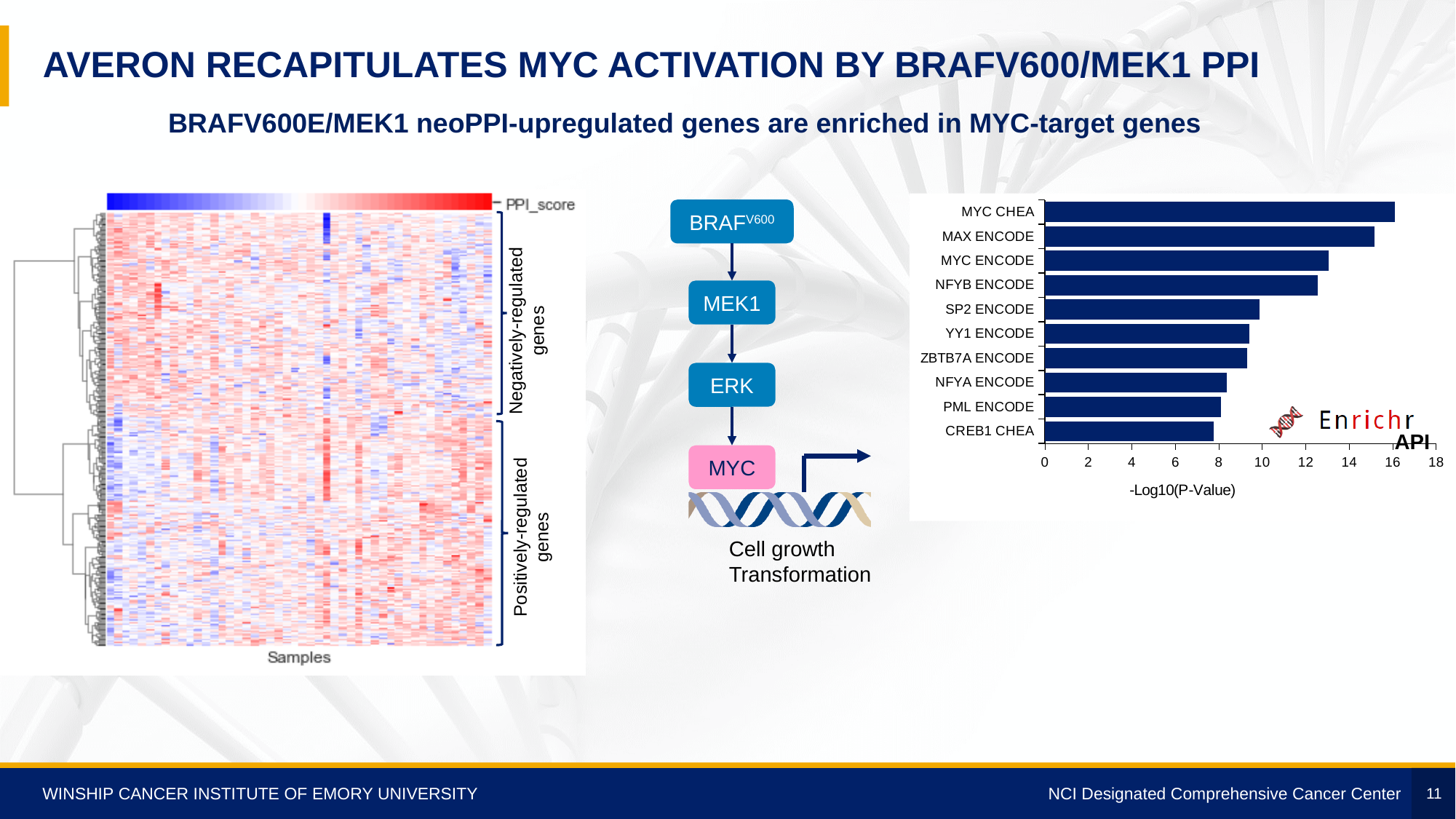
In the bar chart on the right, is the value for PML ENCODE greater or less than 10? less In the bar chart on the right, which has a larger -Log10(P-Value): MYC ENCODE or SP2 ENCODE? MYC ENCODE In the bar chart on the right, which category has the highest -Log10(P-Value)? MYC CHEA In the bar chart on the right, is the value for SP2 ENCODE greater or less than 8? greater In the bar chart on the right, which category has the lowest -Log10(P-Value)? CREB1 CHEA In the bar chart on the right, which has a larger -Log10(P-Value): MYC CHEA or MAX ENCODE? MYC CHEA In the bar chart on the right, what is the label of the horizontal axis? -Log10(P-Value) In the bar chart on the right, how many categories are plotted? 10 In the bar chart on the right, is the value for MYC CHEA greater or less than 14? greater What kind of chart is shown on the right side of the slide? Bar chart